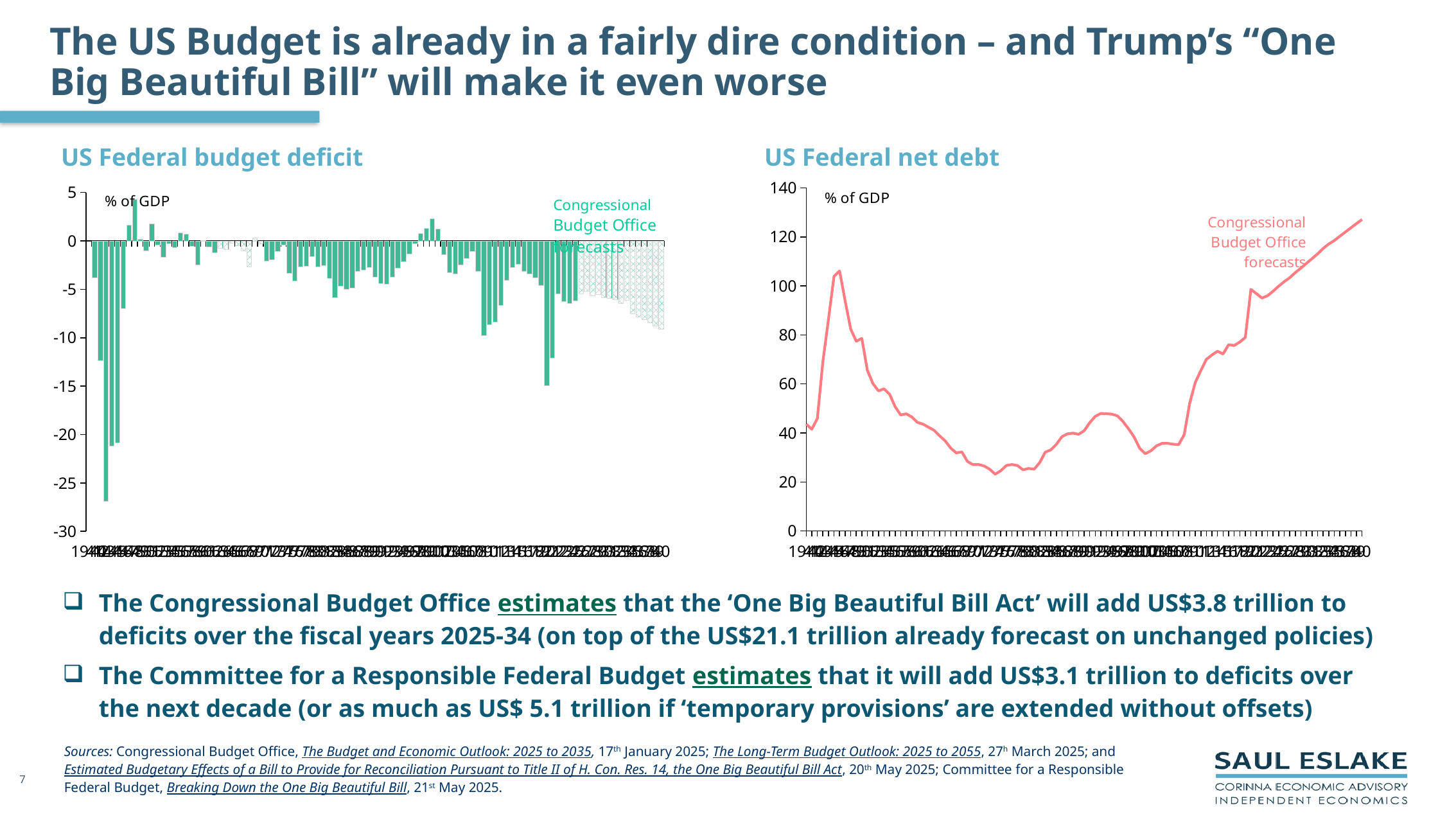
In the 'US Federal net debt' chart, does the line rise or fall over the Congressional Budget Office forecast period at the right-hand end? rise In the 'US Federal budget deficit' chart, is the highest bar greater or less than 5? less In the 'US Federal budget deficit' chart, what unit is shown on the vertical axis? % of GDP In the 'US Federal net debt' chart, is the highest point of the line greater or less than 120? greater What kind of chart is the 'US Federal net debt' chart? Line chart In the 'US Federal budget deficit' chart, is the lowest bar greater or less than -25? less What kind of chart is the 'US Federal budget deficit' chart? Bar chart In the 'US Federal budget deficit' chart, what do the hatched bars at the right-hand end represent? Congressional Budget Office forecasts